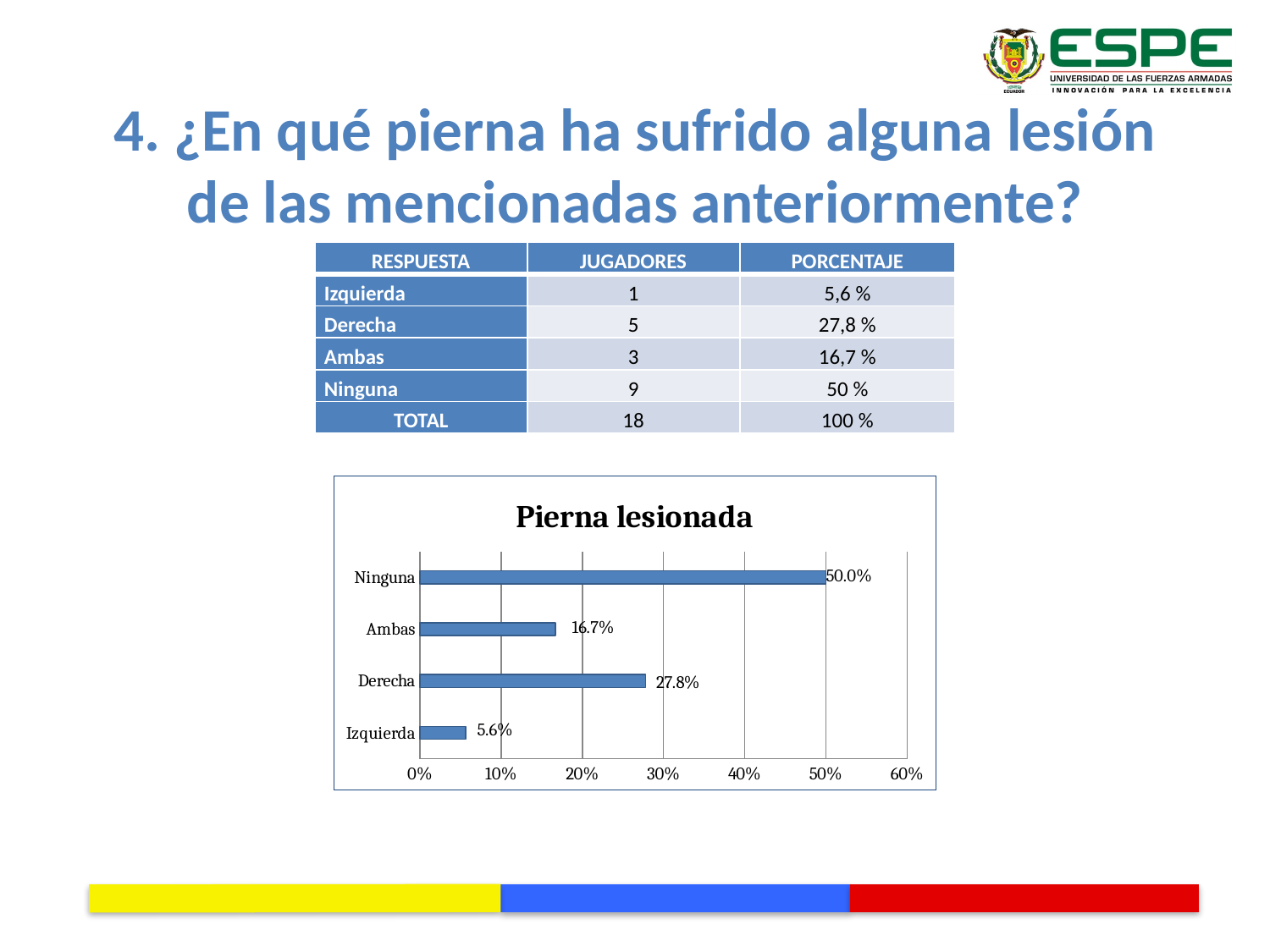
Which is larger in the Pierna lesionada chart, the value for Ambas or the value for Derecha? Derecha Which category has the lowest value in the Pierna lesionada chart? Izquierda What is the value for Ninguna in the Pierna lesionada chart? 50.0% What is the value for Ambas in the Pierna lesionada chart? 16.7% Which category has the highest value in the Pierna lesionada chart? Ninguna What is the title of the chart on the slide? Pierna lesionada What is the difference between the values for Ninguna and Derecha in the Pierna lesionada chart? 22.2% Is the value for Derecha in the Pierna lesionada chart greater or less than 20%? greater What is the value for Derecha in the Pierna lesionada chart? 27.8% How many categories are shown in the Pierna lesionada chart? 4 What kind of chart is the Pierna lesionada chart? bar chart What is the value for Izquierda in the Pierna lesionada chart? 5.6%